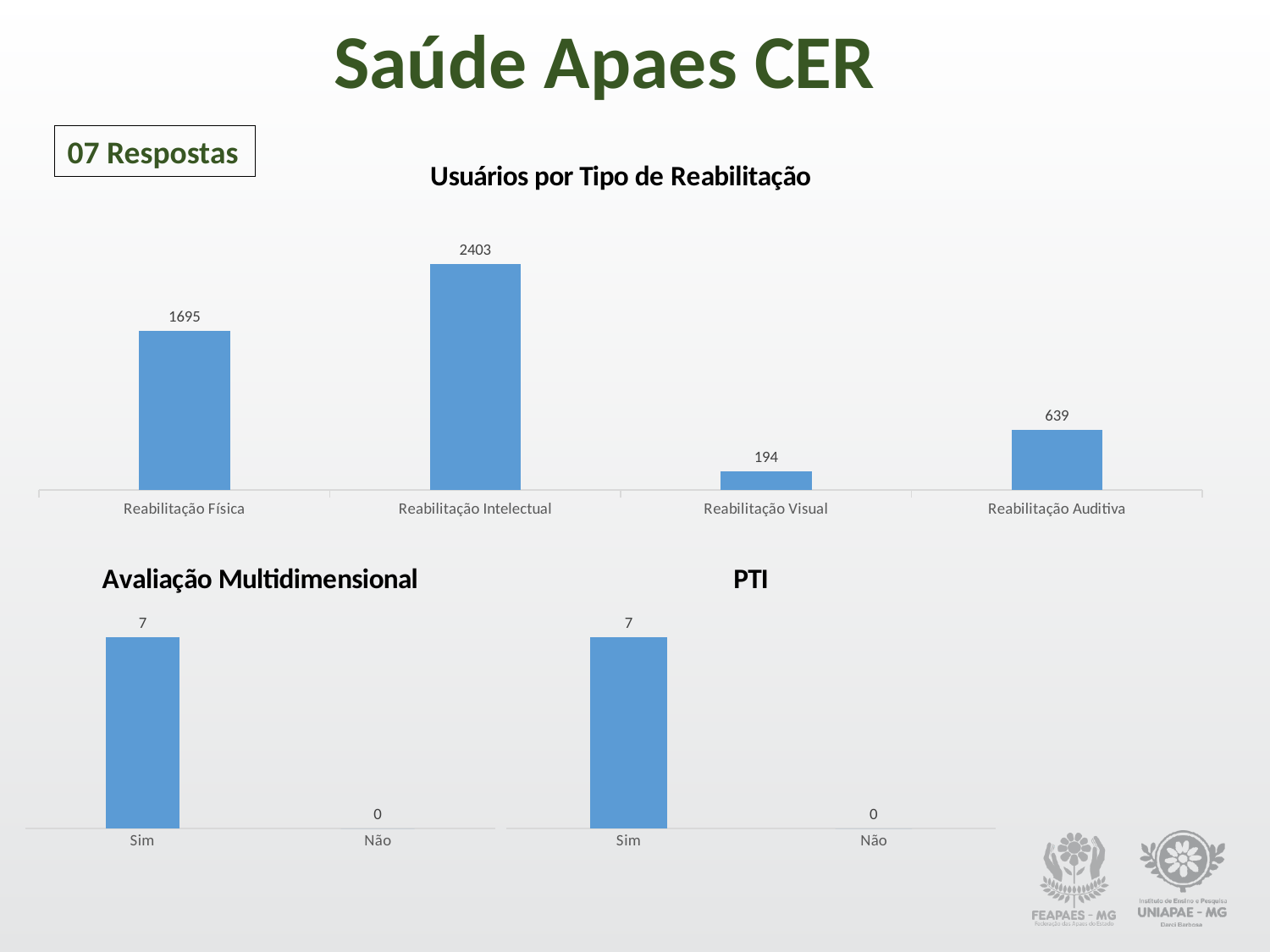
What kind of chart is 'Usuários por Tipo de Reabilitação'? Bar chart In the 'Usuários por Tipo de Reabilitação' chart, what is the value for Reabilitação Intelectual? 2403 In the 'Usuários por Tipo de Reabilitação' chart, which category has the highest value? Reabilitação Intelectual In the 'PTI' chart, what is the difference between Sim and Não? 7 In the 'Usuários por Tipo de Reabilitação' chart, which is larger: Reabilitação Auditiva or Reabilitação Visual? Reabilitação Auditiva In the 'PTI' chart, what is the value for Não? 0 How many categories are shown in the 'Usuários por Tipo de Reabilitação' chart? 4 In the 'Usuários por Tipo de Reabilitação' chart, what is the difference between Reabilitação Intelectual and Reabilitação Física? 708 In the 'Usuários por Tipo de Reabilitação' chart, which category has the lowest value? Reabilitação Visual How many categories are shown in the 'Avaliação Multidimensional' chart? 2 In the 'Usuários por Tipo de Reabilitação' chart, what is the value for Reabilitação Visual? 194 In the 'Avaliação Multidimensional' chart, what is the value for Sim? 7